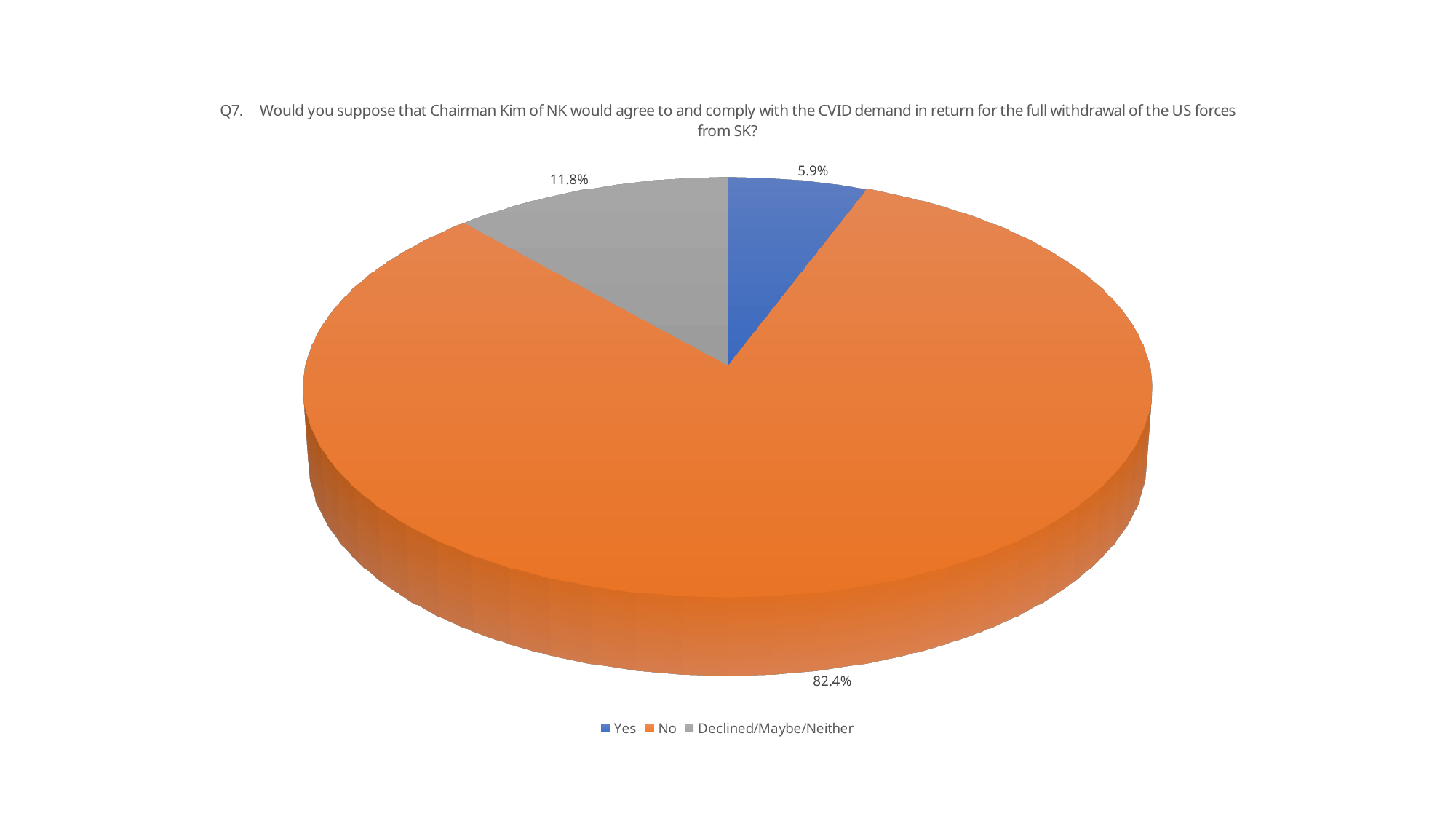
What kind of chart is shown on the slide? Pie chart What is the difference in percentage points between the "No" and "Yes" shares? 76.5 What question number is shown in the chart title? Q7 What is the difference in percentage points between the "Declined/Maybe/Neither" and "Yes" shares? 5.9 Which is larger, the share for "Yes" or the share for "Declined/Maybe/Neither"? Declined/Maybe/Neither How many categories does the pie chart show? 3 Which response has the smallest share of the pie? Yes Which response has the largest share of the pie? No What colour is the "No" slice? Orange What percentage of respondents answered "No"? 82.4% What percentage of respondents answered "Yes"? 5.9% What percentage of respondents answered "Declined/Maybe/Neither"? 11.8%